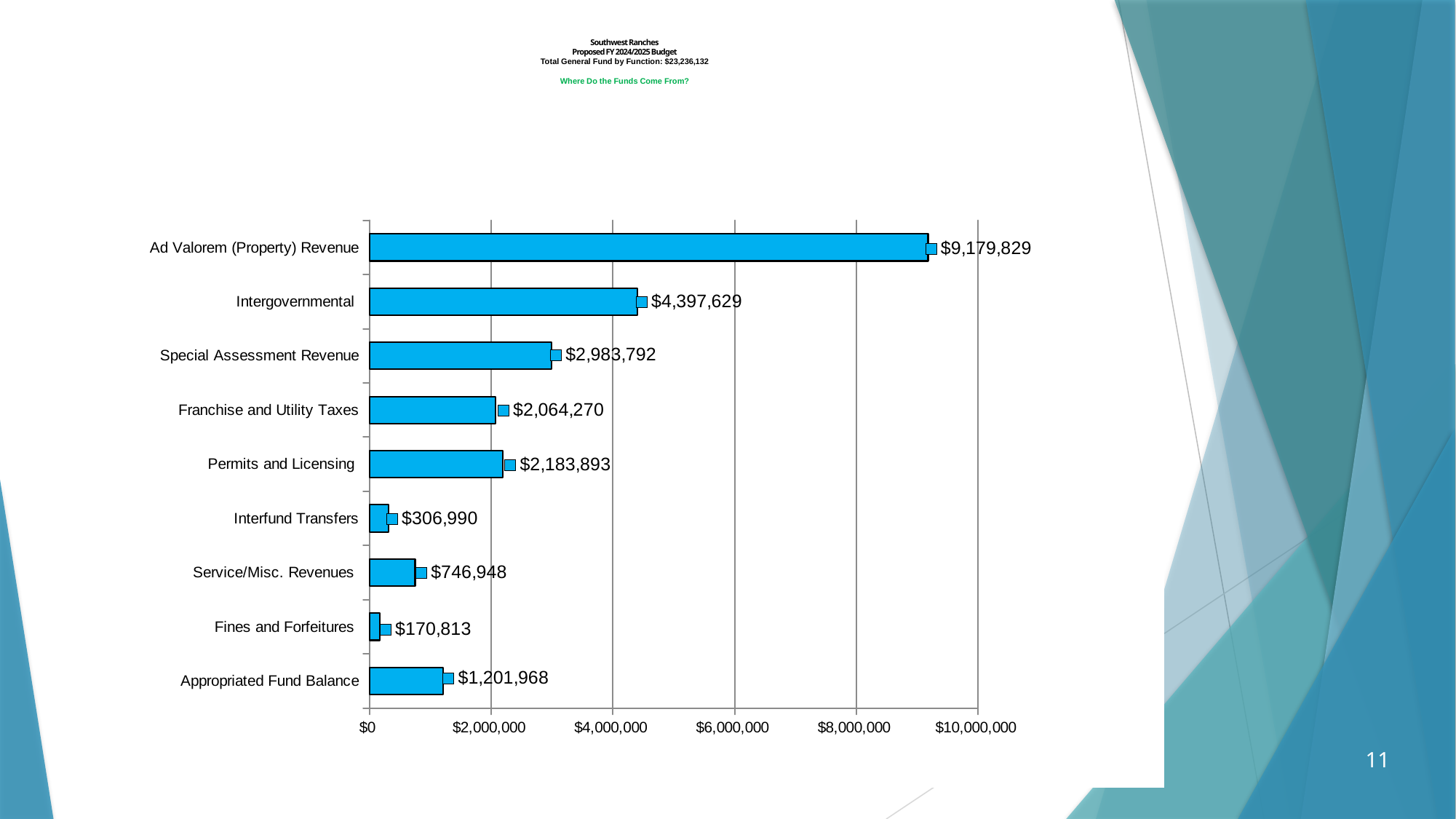
Which category has the highest value? Ad Valorem (Property) Revenue Is the value for Special Assessment Revenue greater or less than $2,000,000? greater What is the difference between Intergovernmental and Special Assessment Revenue? $1,413,837 Which is larger, Permits and Licensing or Franchise and Utility Taxes? Permits and Licensing How many categories are shown in the chart? 9 What is the value for Fines and Forfeitures? $170,813 Which category has the lowest value? Fines and Forfeitures What is the value for Ad Valorem (Property) Revenue? $9,179,829 What is the total general fund amount stated in the chart title? $23,236,132 What is the value for Intergovernmental? $4,397,629 What is the value for Appropriated Fund Balance? $1,201,968 What kind of chart is shown on the slide? Bar chart